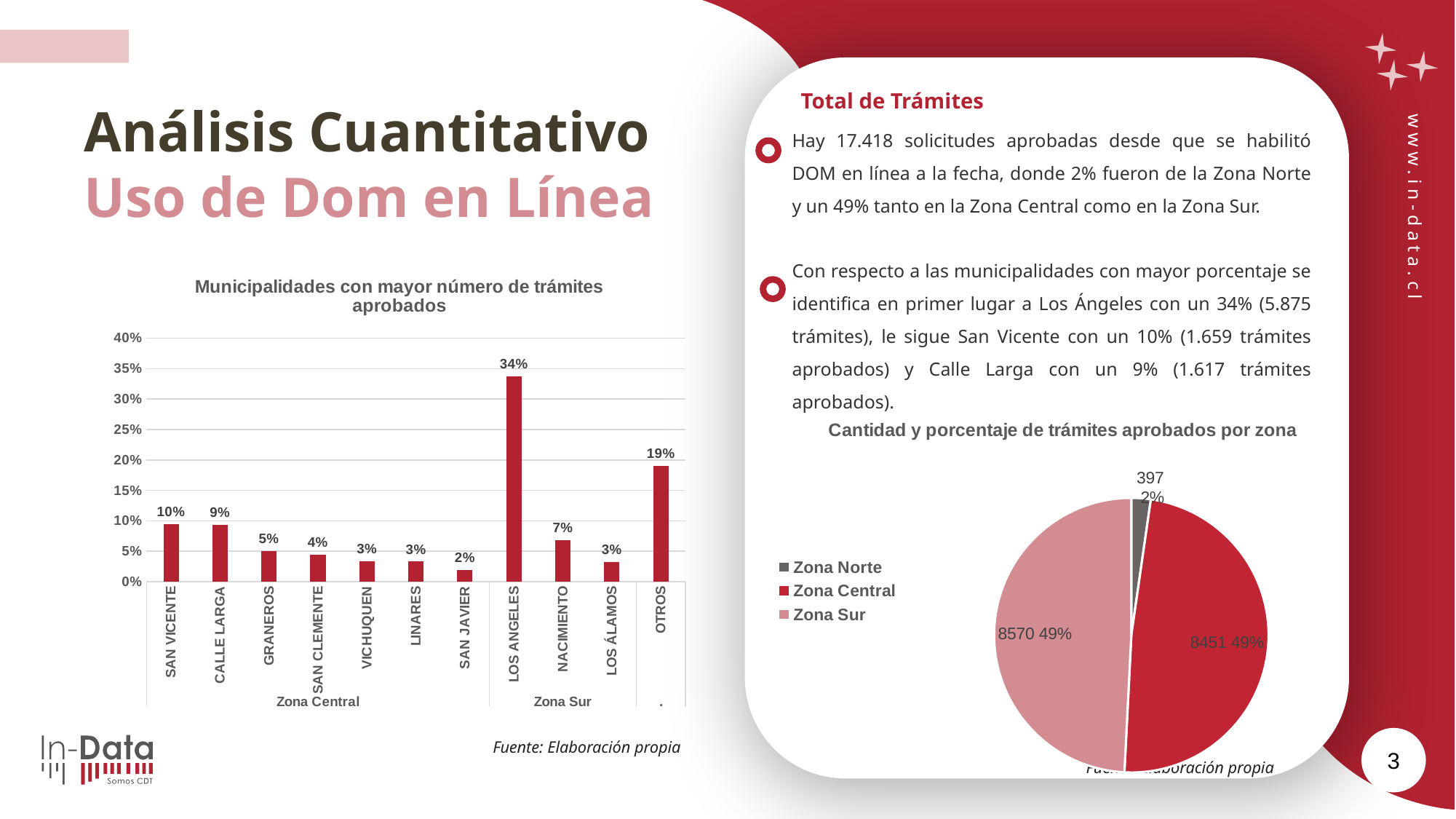
In the pie chart 'Cantidad y porcentaje de trámites aprobados por zona', which zone has the smallest slice? Zona Norte In the bar chart 'Municipalidades con mayor número de trámites aprobados', which is larger, the value for CALLE LARGA or the value for NACIMIENTO? CALLE LARGA How many municipality categories are shown in the bar chart 'Municipalidades con mayor número de trámites aprobados'? 11 What kind of chart is 'Municipalidades con mayor número de trámites aprobados'? Bar chart In the bar chart 'Municipalidades con mayor número de trámites aprobados', what is the difference between the values for LOS ANGELES and OTROS? 15% In the bar chart 'Municipalidades con mayor número de trámites aprobados', which municipality has the highest value? LOS ANGELES In the bar chart 'Municipalidades con mayor número de trámites aprobados', what is the value for LOS ANGELES? 34% How many entries does the legend of the pie chart 'Cantidad y porcentaje de trámites aprobados por zona' list? 3 In the pie chart 'Cantidad y porcentaje de trámites aprobados por zona', what is the count shown for Zona Norte? 397 In the bar chart 'Municipalidades con mayor número de trámites aprobados', what is the value for SAN VICENTE? 10% In the bar chart 'Municipalidades con mayor número de trámites aprobados', which municipality has the lowest value? SAN JAVIER In the pie chart 'Cantidad y porcentaje de trámites aprobados por zona', what share does Zona Sur have? 49%